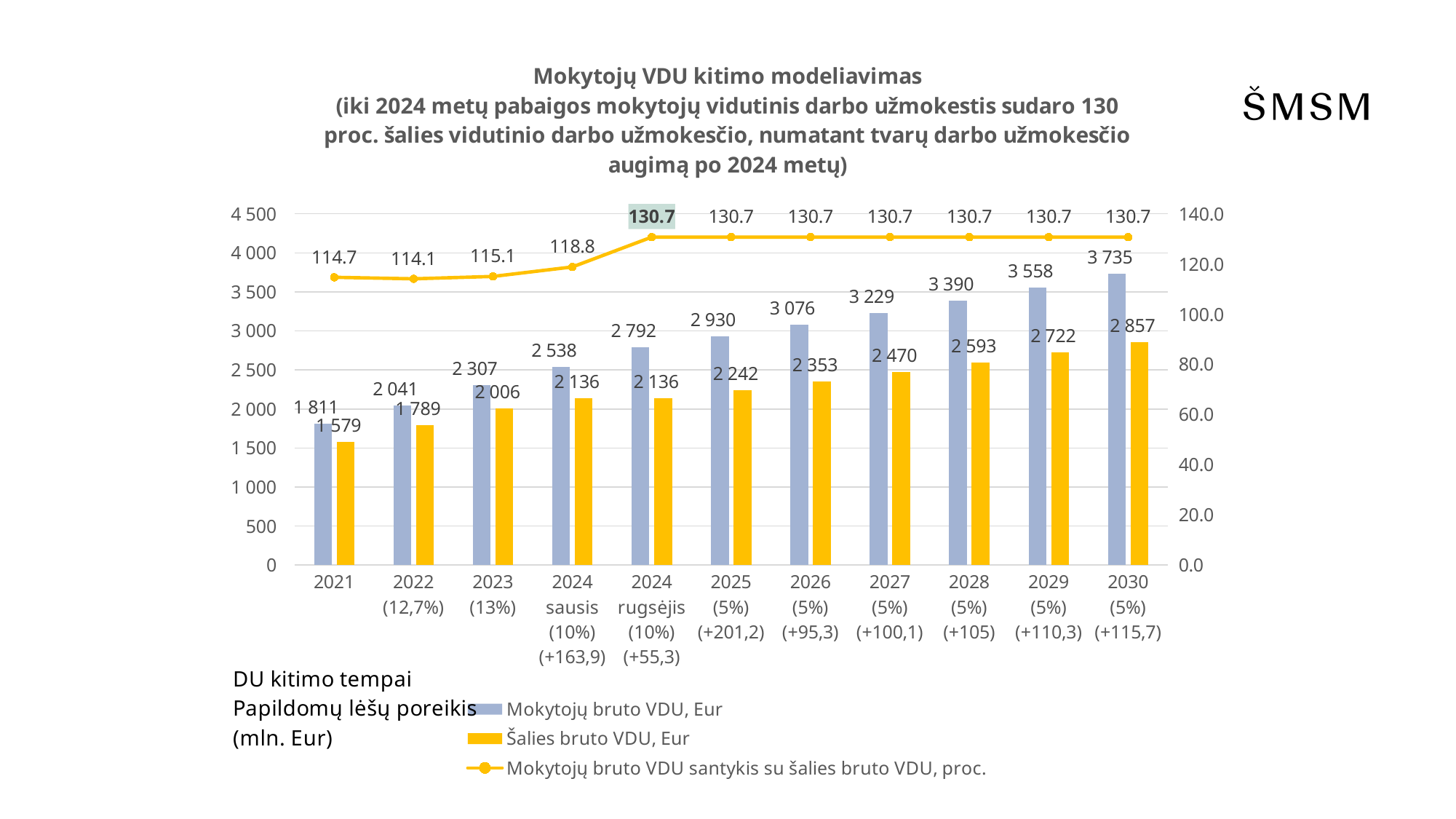
What is the difference between Mokytojų bruto VDU, Eur and Šalies bruto VDU, Eur in 2027? 759 Does the Mokytojų bruto VDU, Eur series rise or fall from 2021 to 2030? rise What is the value of Šalies bruto VDU, Eur for 2021? 1 579 How many categories are shown on the x axis? 11 Which is larger in 2025: Mokytojų bruto VDU, Eur or Šalies bruto VDU, Eur? Mokytojų bruto VDU, Eur What is the Mokytojų bruto VDU santykis su šalies bruto VDU, proc. value for 2022? 114.1 Which category has the lowest Mokytojų bruto VDU, Eur value? 2021 What colour are the Šalies bruto VDU, Eur bars? yellow Which category has the highest Šalies bruto VDU, Eur value? 2030 How many series does the legend list? 3 What is the value of Mokytojų bruto VDU, Eur for 2030? 3 735 What is the value of Mokytojų bruto VDU, Eur for 2024 rugsėjis? 2 792